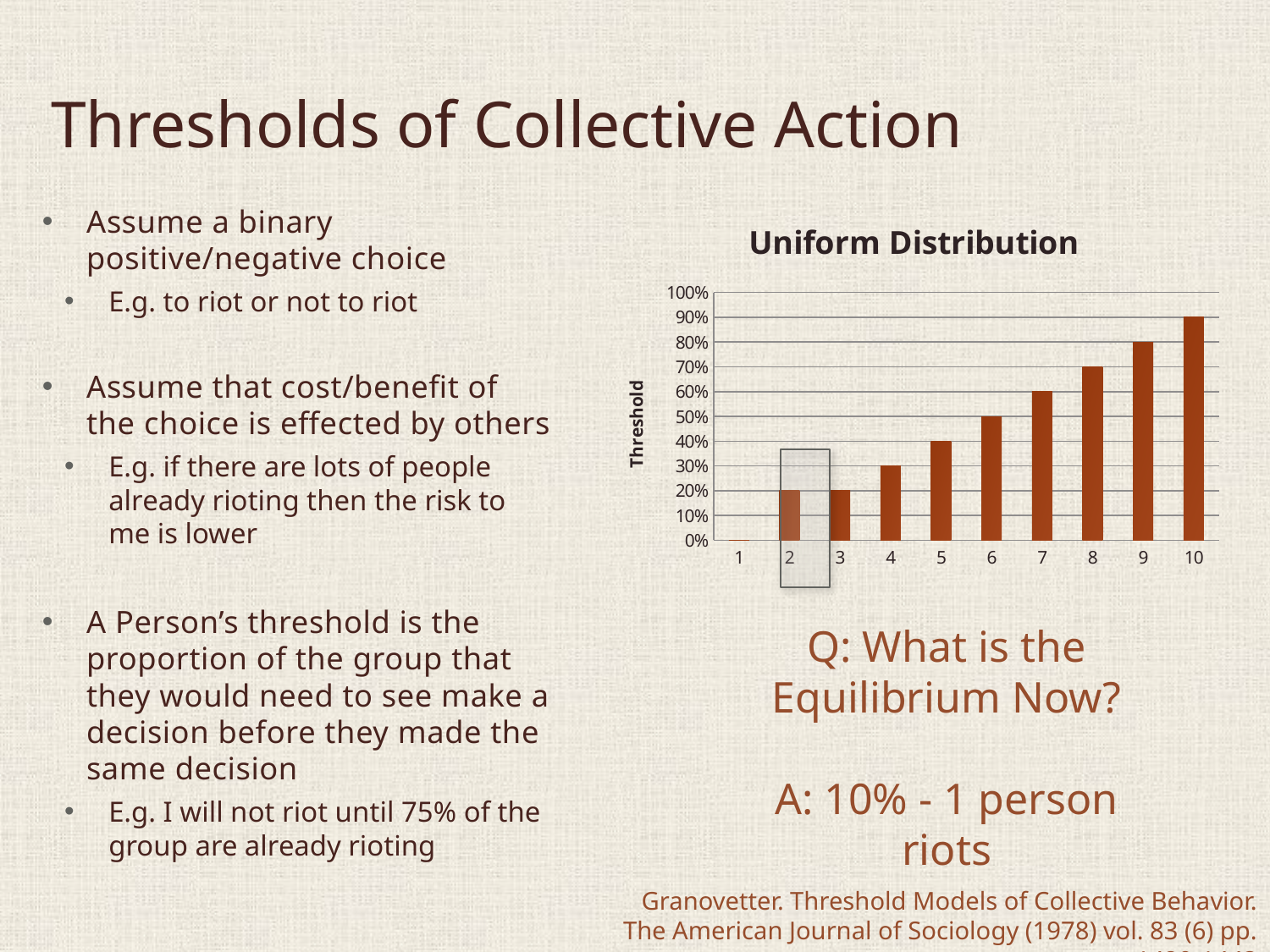
Which category has the highest threshold? 10 Is the threshold for category 8 greater or less than 50%? greater Do the threshold values generally rise or fall from category 1 to category 10? rise What is the threshold value for category 10? 90% What is the title of the chart? Uniform Distribution What kind of chart is shown on the slide? bar chart What is the threshold value for category 2? 20% What is the threshold value for category 6? 50% Which category has the lowest threshold? 1 What is the label of the vertical axis of the chart? Threshold How many categories are shown on the x axis of the chart? 10 Which has a larger threshold, category 4 or category 7? 7